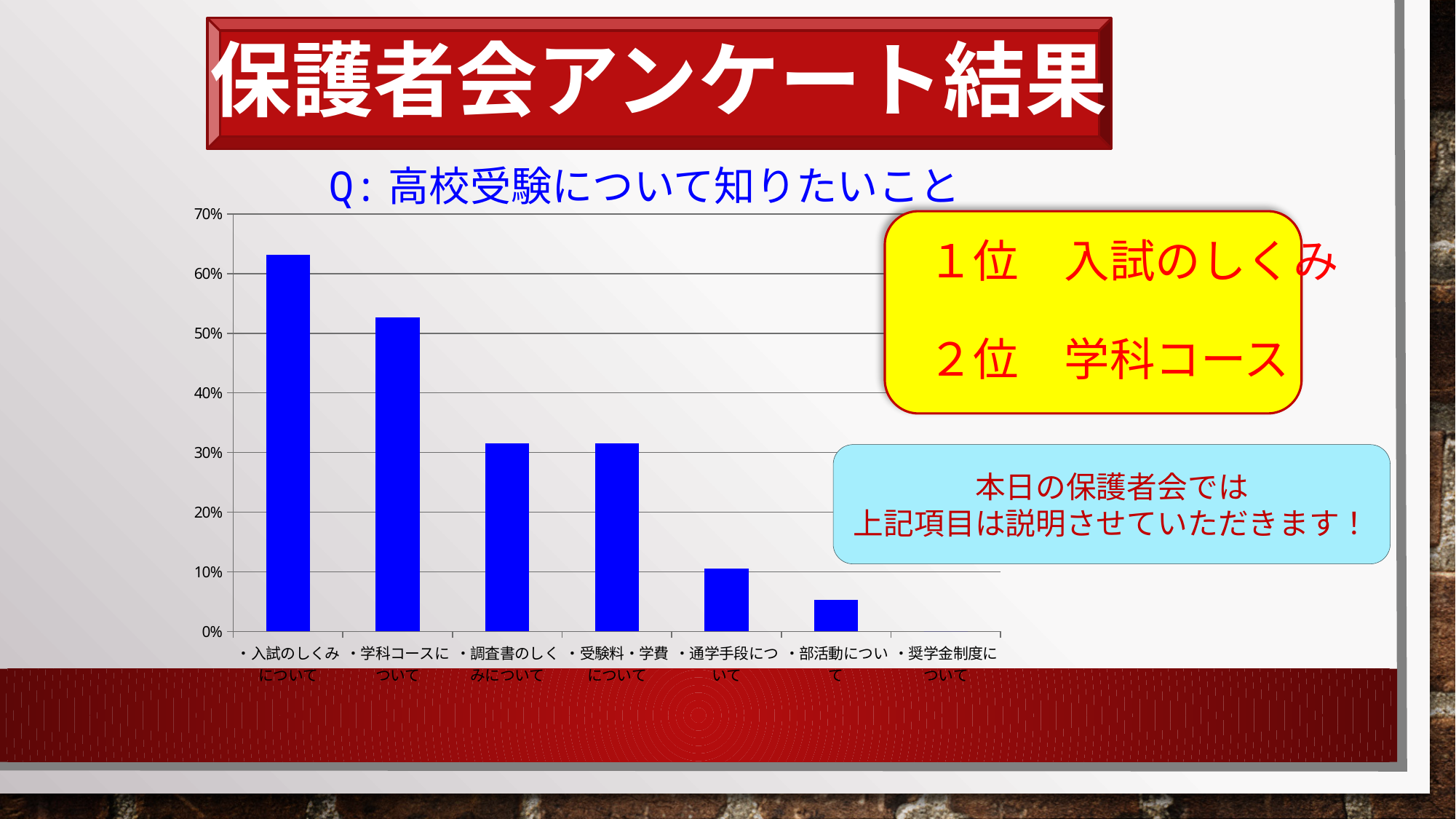
How many categories are shown on the x axis of the chart? 7 What colour are the bars in the chart? blue Do the bar values rise or fall from left to right along the x axis? fall Which category has the lowest value in the chart? 奨学金制度について Is the value for 調査書のしくみについて greater or less than 30%? greater Which is larger, the value for 入試のしくみについて or the value for 学科コースについて? 入試のしくみについて What kind of chart is shown on the slide? bar chart Is the value for 学科コースについて greater or less than 50%? greater Is the value for 部活動について greater or less than 10%? less Which category has the highest bar in the chart? 入試のしくみについて What is the title of the chart? Q：高校受験について知りたいこと